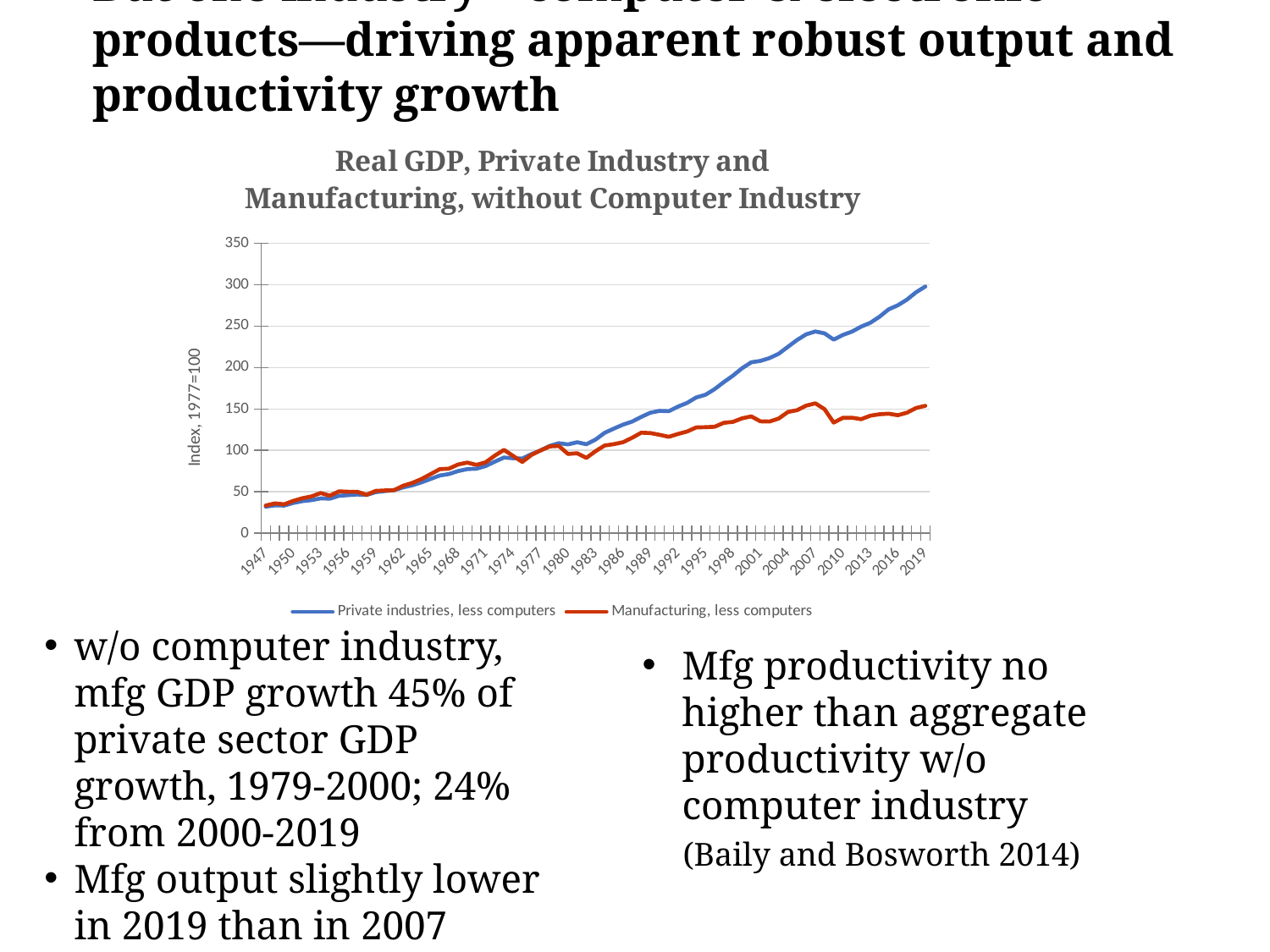
Does the Private industries, less computers series generally rise or fall from 1947 to 2019? rise Is the value for Manufacturing, less computers in 2019 greater or less than 200? less Is the value for Private industries, less computers in 2007 greater or less than 200? greater In 2019, which series has the higher value: Private industries, less computers or Manufacturing, less computers? Private industries, less computers Is the value for Private industries, less computers in 1947 greater or less than 50? less How many series does the chart's legend list? 2 Which series reaches the highest value on the chart? Private industries, less computers What is the title of the chart? Real GDP, Private Industry and Manufacturing, without Computer Industry According to the y-axis label, which year is the base year of the index (set to 100)? 1977 What kind of chart is shown on the slide? line chart In 2001, which series has the higher value: Private industries, less computers or Manufacturing, less computers? Private industries, less computers